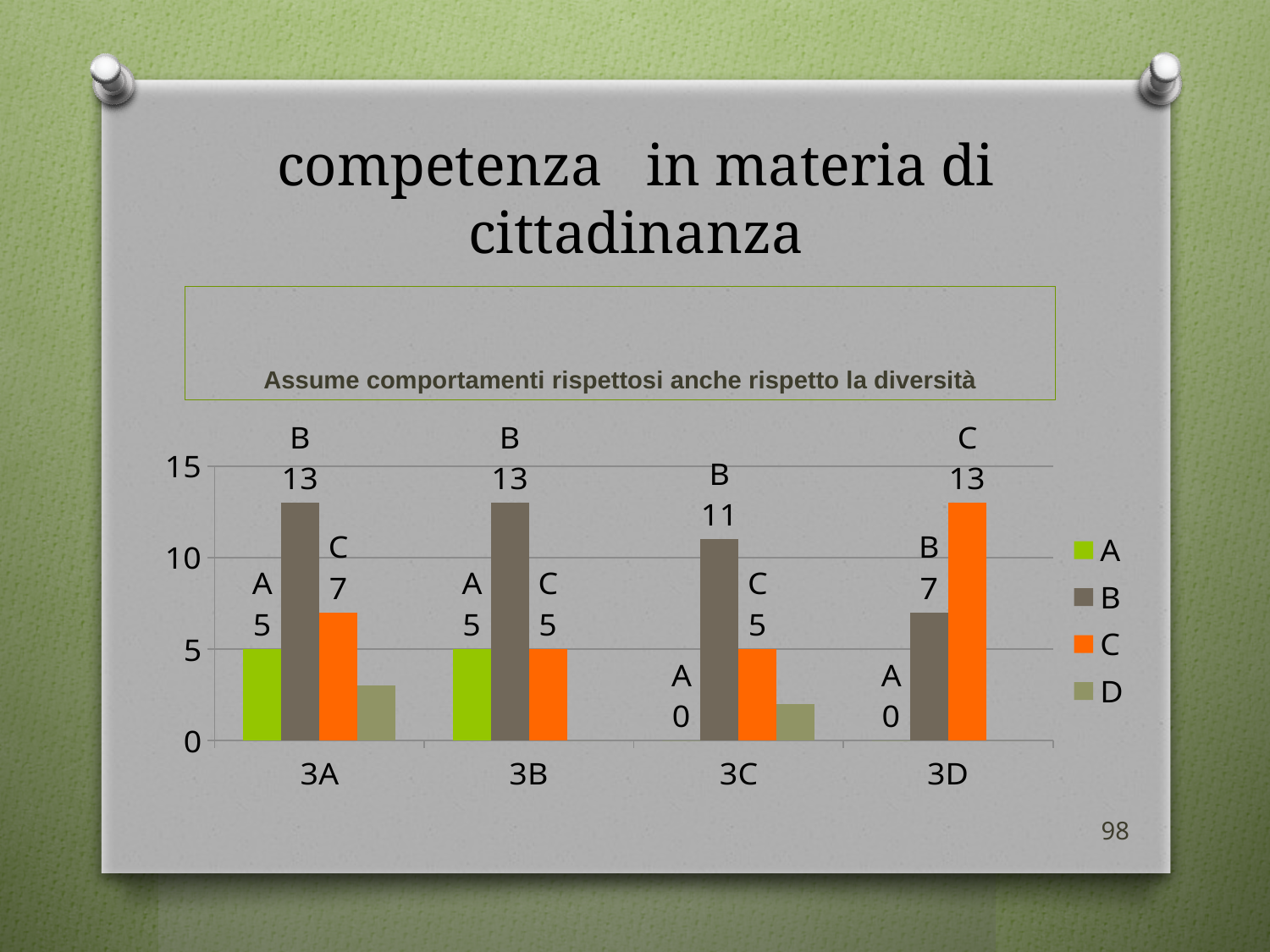
Which series has the highest value for class 3D? C Which series has the highest value for class 3C? B How many series does the legend list? 4 What is the value of series B for class 3D? 7 Which is larger for class 3D: series B or series C? C What is the value of series B for class 3A? 13 How many classes are shown on the x axis? 4 What kind of chart is shown on the slide? bar chart What is the value of series C for class 3D? 13 What is the difference between series B and series C for class 3A? 6 Is the value of series D for class 3A greater or less than 5? less What is the value of series A for class 3C? 0